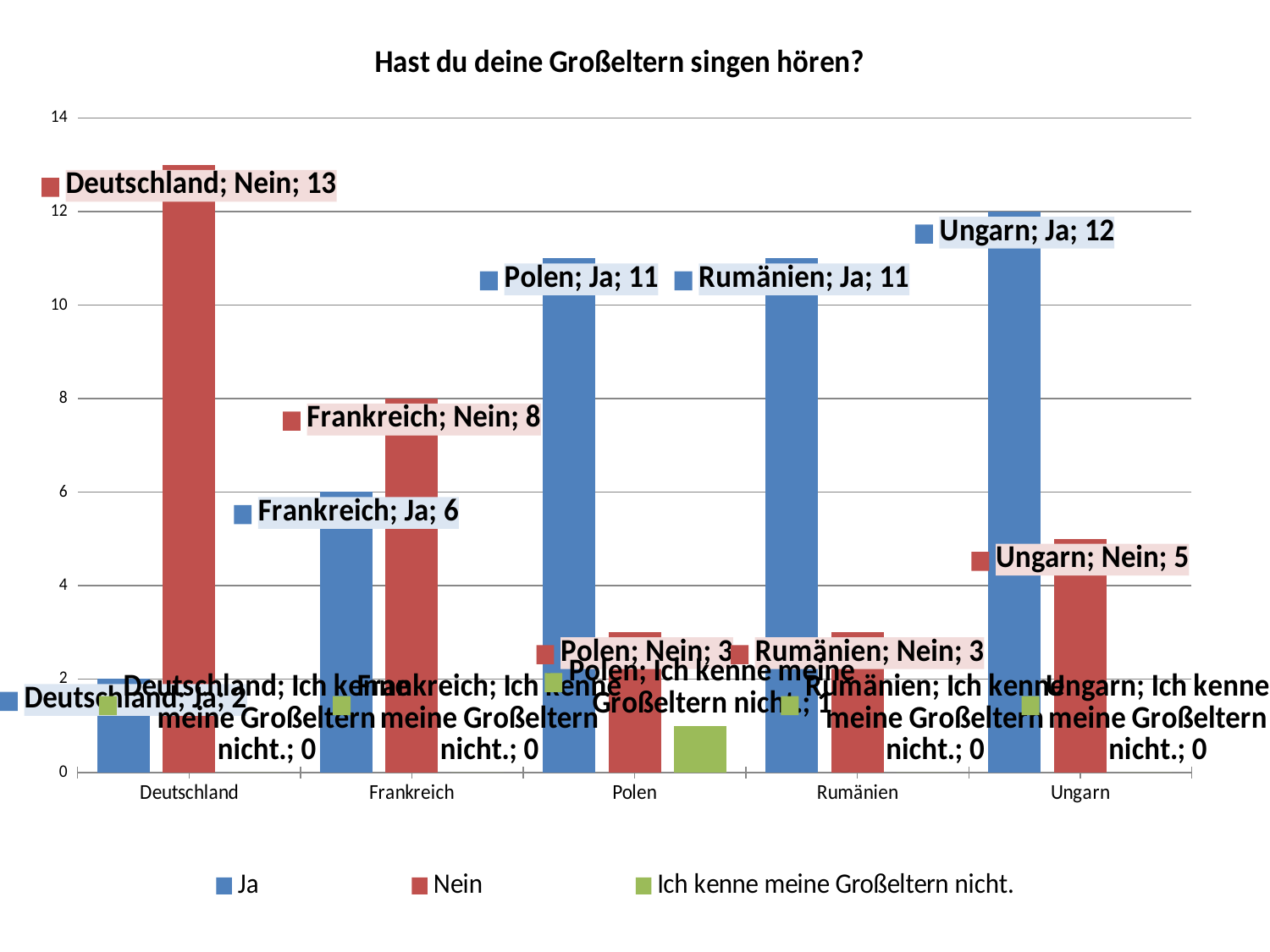
Which country has the lowest value for Ja? Deutschland Which country has a value of 1 for 'Ich kenne meine Großeltern nicht.'? Polen What type of chart is shown on the slide? bar chart What is the value for Ja in Ungarn? 12 How many series does the legend list? 3 What is the title of the chart? Hast du deine Großeltern singen hören? Which country has the highest value for Ja? Ungarn What is the difference between the Nein value for Deutschland and the Nein value for Ungarn? 8 What is the value for Nein in Deutschland? 13 What is the value for Nein in Frankreich? 8 Which is larger in Frankreich, the Ja value or the Nein value? Nein How many countries are shown on the x axis? 5